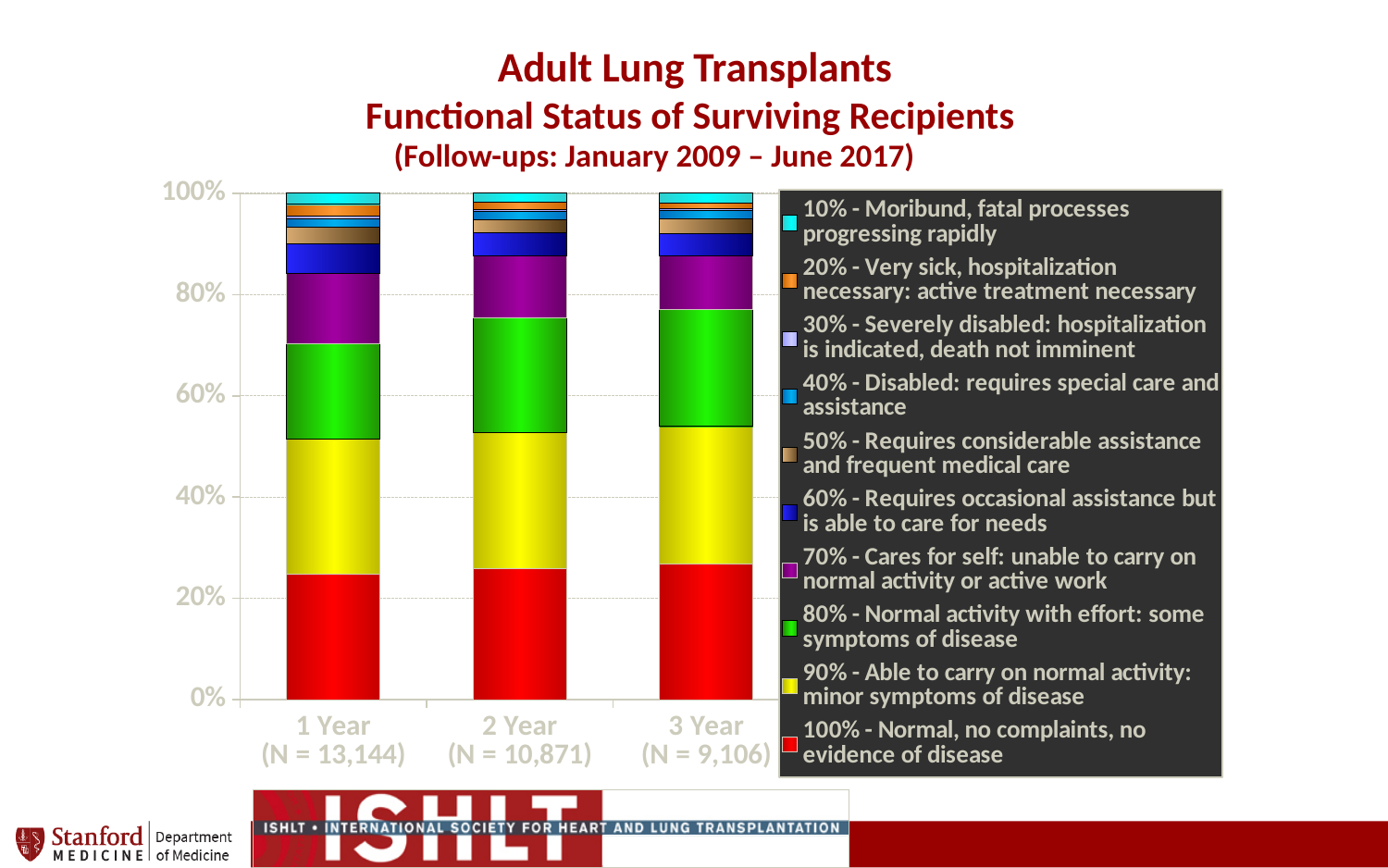
Is the cumulative top of the '90% - Able to carry on normal activity' segment for 3 Year greater or less than 60%? less What is the sample size (N) shown for the 3 Year category? N = 9,106 Does the '100% - Normal, no complaints' (red) segment rise or fall from 1 Year to 3 Year? Rise What is the sample size (N) shown for the 1 Year category? N = 13,144 Which category has the larger '80% - Normal activity with effort' (green) segment, 1 Year or 3 Year? 3 Year What kind of chart is shown on the slide? Stacked bar chart How many series does the legend list? 10 How many categories (follow-up time points) are shown on the x axis? 3 What is the total height of each stacked bar? 100% Is the cumulative top of the '80% - Normal activity with effort' segment for 1 Year greater or less than 80%? less Is the cumulative top of the '70% - Cares for self' segment for 2 Year greater or less than 80%? greater